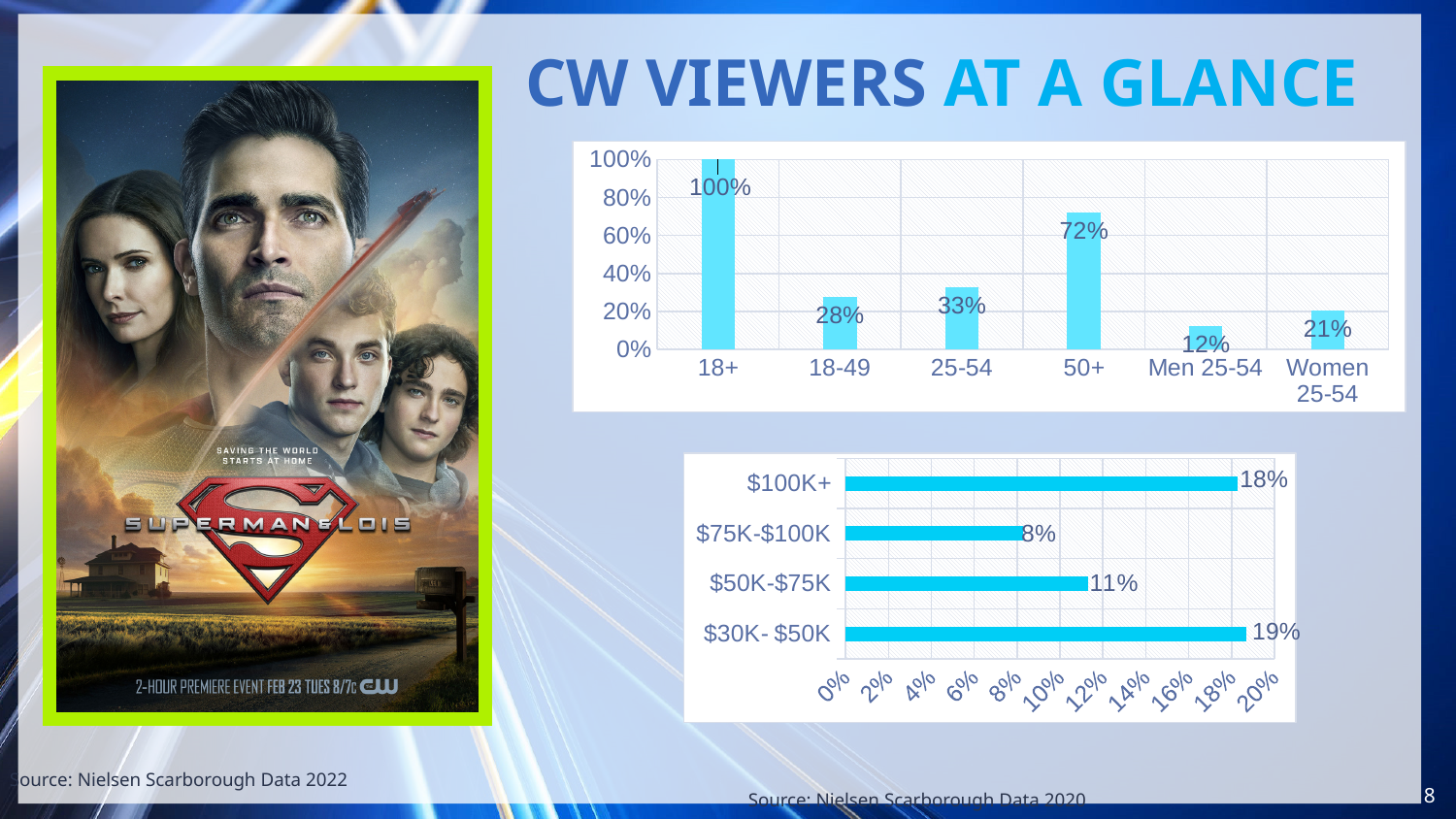
What kind of chart is the bottom chart? Bar chart In the top chart, what is the difference between the values for 25-54 and 18-49? 5% How many categories are shown in the top chart? 6 In the bottom chart, what is the value for $75K-$100K? 8% In the top chart, which category has the lowest value? Men 25-54 In the bottom chart, what is the difference between the values for $100K+ and $50K-$75K? 7% In the top chart, which is larger, the value for 50+ or the value for Women 25-54? 50+ In the bottom chart, which income group has the highest value? $30K- $50K In the bottom chart, is the value for $50K-$75K greater or less than 10%? greater In the top chart, what is the value for 50+? 72% How many categories are shown in the bottom chart? 4 In the top chart, what is the value for Men 25-54? 12%